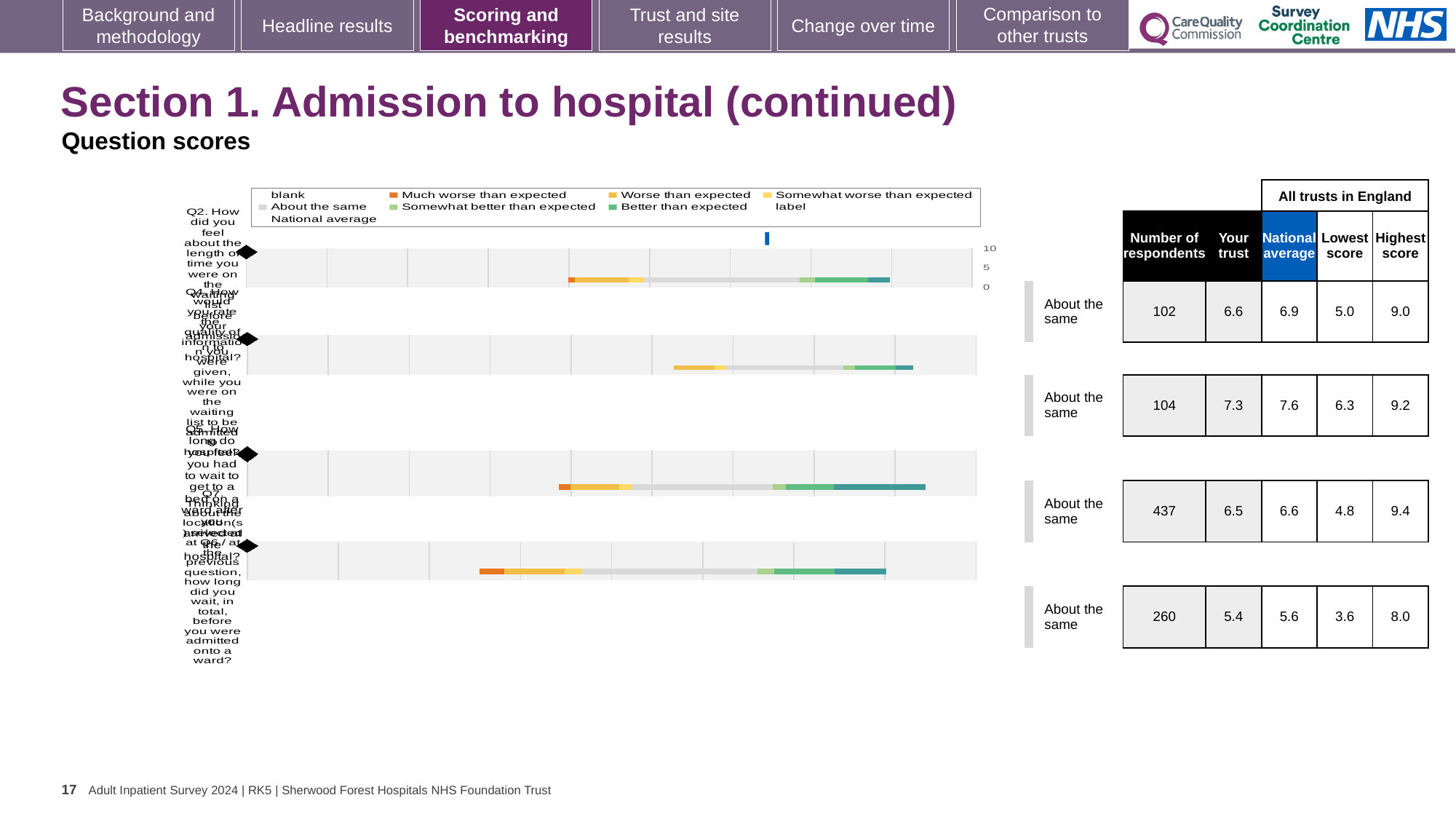
What is the maximum value shown on the chart's score axis? 10 In the table beside the chart, what is the lowest 'Lowest score' value across the four rows? 3.6 How many question rows (bars) does the chart show? 4 What kind of chart is shown on the slide? bar chart What benchmark label is shown next to each of the four chart rows? About the same In the table beside the chart, what is the 'Your trust' score for the top row? 6.6 In the table beside the chart, what is the number of respondents for the third row? 437 In the table beside the chart, which row has the highest 'Highest score' value? third row (9.4) In the table beside the chart, what is the national average for the bottom row? 5.6 In the table beside the chart, is the number of respondents for the bottom row greater or less than 200? greater In the table beside the chart, for the bottom row, which is larger: the 'Your trust' score or the national average? national average In the table beside the chart, what is the difference between the national average and the 'Your trust' score for the second row? 0.3